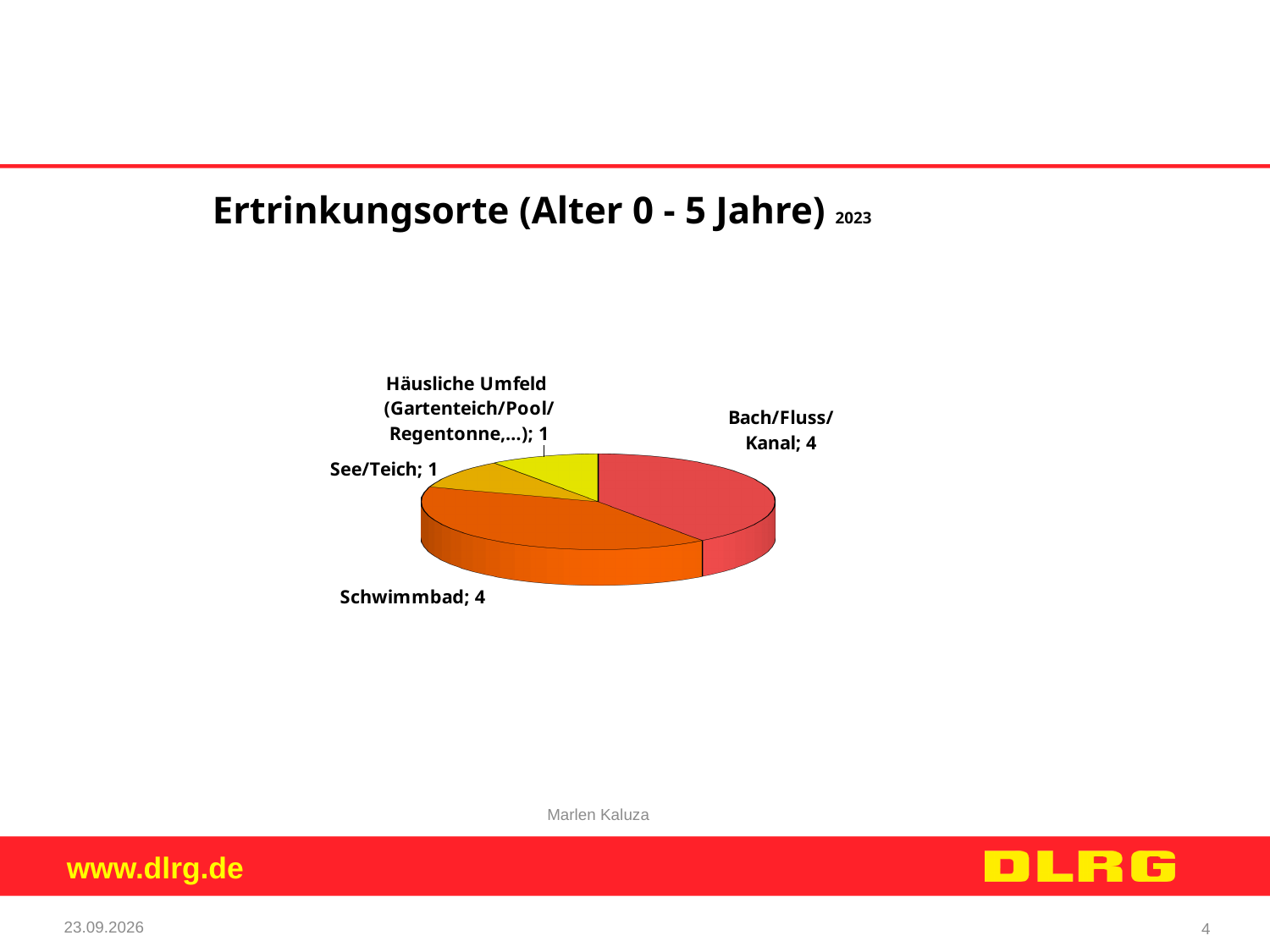
What is the value for Häusliche Umfeld (Gartenteich/Pool/Regentonne,...)? 1 What is the value for Schwimmbad? 4 What kind of chart is shown on the slide? pie chart What is the total of all slices in the pie chart? 10 What share of the pie does See/Teich represent? 10% What is the difference between the value for Bach/Fluss/Kanal and the value for Häusliche Umfeld (Gartenteich/Pool/Regentonne,...)? 3 Which is larger, the value for Schwimmbad or the value for See/Teich? Schwimmbad What share of the pie does Schwimmbad represent? 40% What is the value for See/Teich? 1 What is the title of the chart? Ertrinkungsorte (Alter 0 - 5 Jahre) 2023 What is the value for Bach/Fluss/Kanal? 4 How many slices does the pie chart have? 4